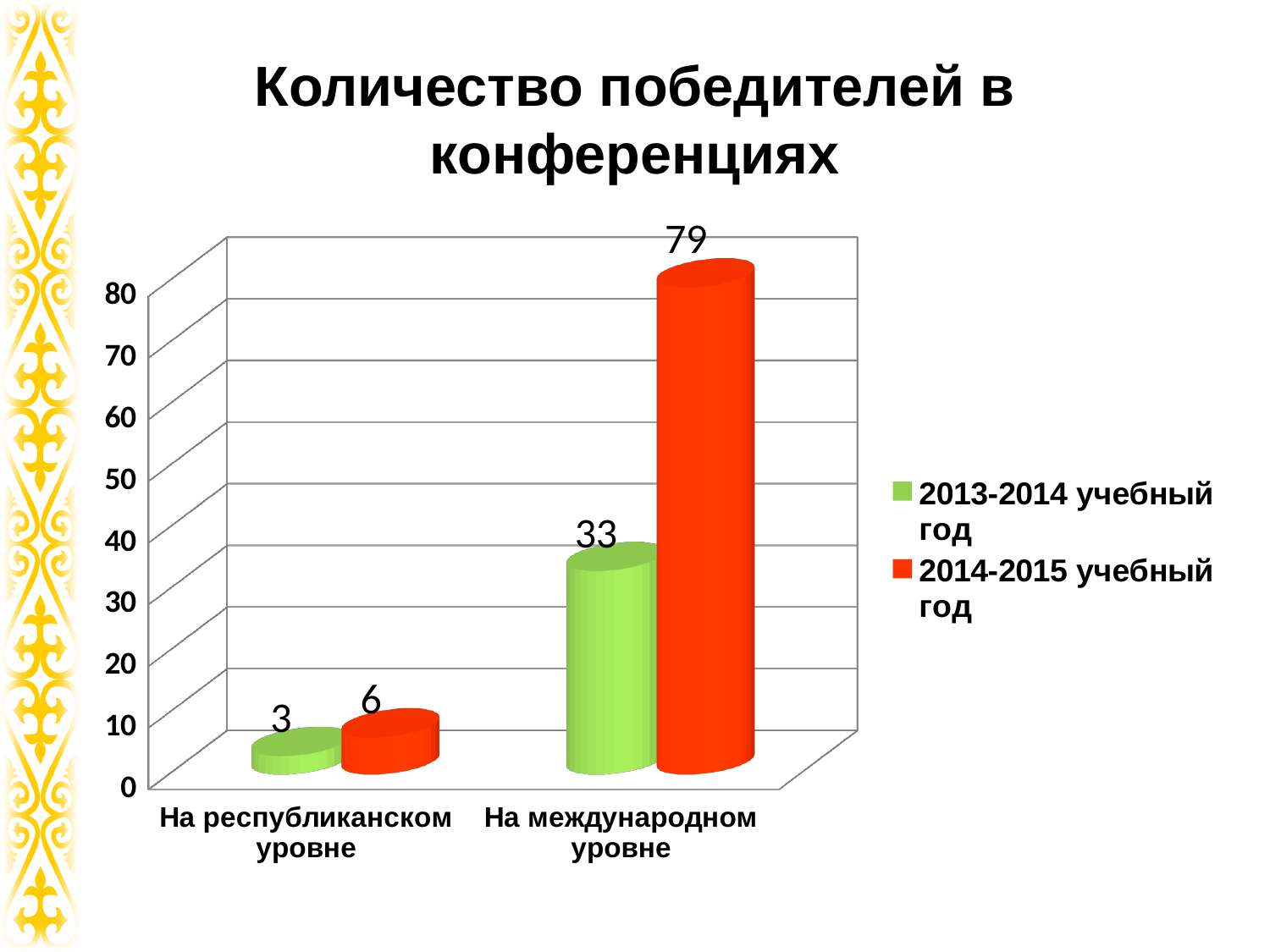
What is the title of the chart? Количество победителей в конференциях What is the value for 2013-2014 учебный год at На республиканском уровне? 3 What is the value for 2014-2015 учебный год at На республиканском уровне? 6 Which category has the highest value for 2014-2015 учебный год? На международном уровне Which is larger at На республиканском уровне: 2013-2014 учебный год or 2014-2015 учебный год? 2014-2015 учебный год What is the value for 2013-2014 учебный год at На международном уровне? 33 How many series does the legend list? 2 Which category has the lowest value for 2013-2014 учебный год? На республиканском уровне How many categories are shown on the x axis? 2 What is the value for 2014-2015 учебный год at На международном уровне? 79 What is the difference between the 2014-2015 учебный год and 2013-2014 учебный год values at На международном уровне? 46 What kind of chart is shown on the slide? Bar chart